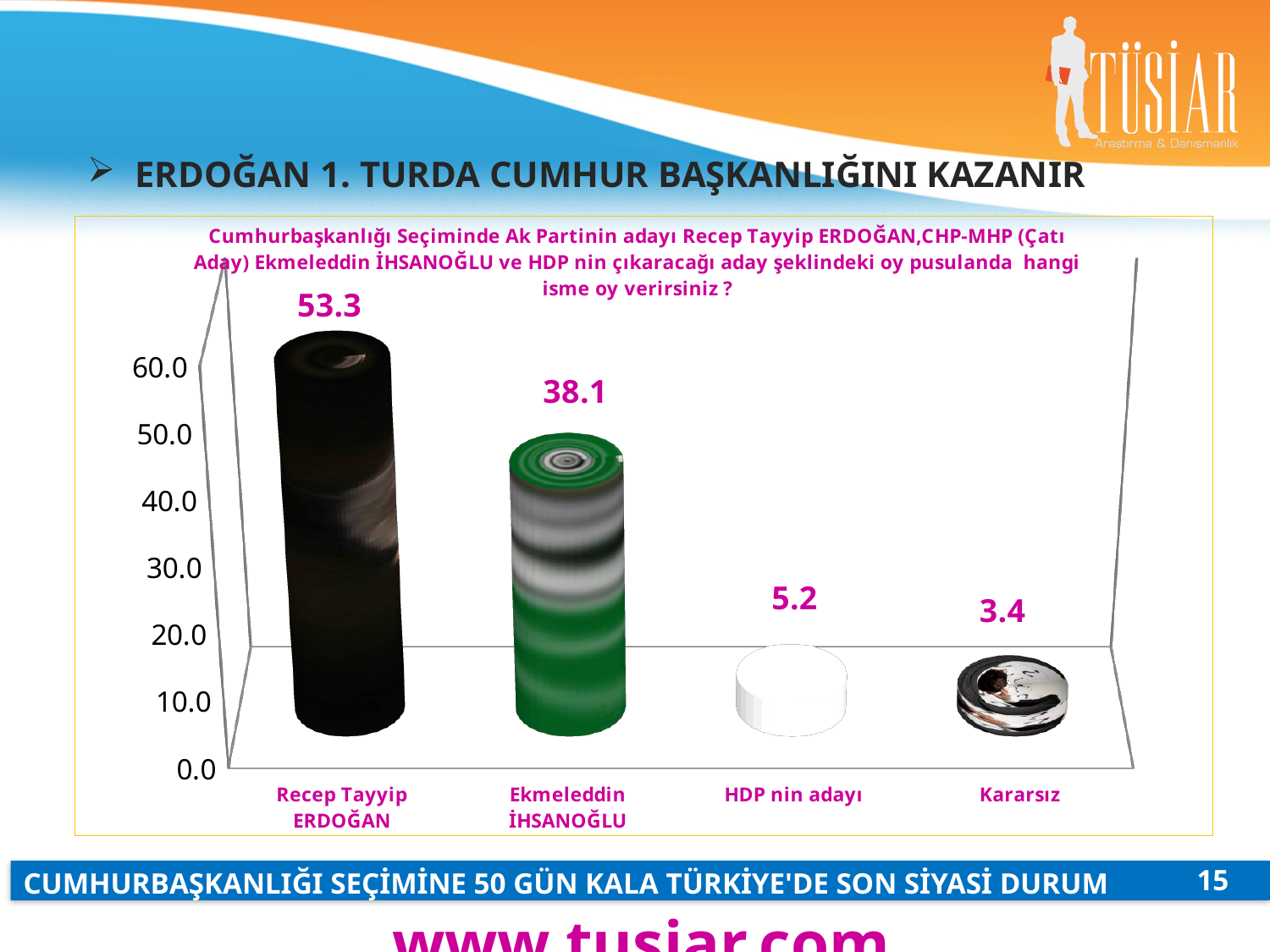
What is the value for Ekmeleddin İHSANOĞLU? 38.1 Do the values rise or fall from left to right along the x axis? fall What is the value for Kararsız? 3.4 Which category has the highest value? Recep Tayyip ERDOĞAN What kind of chart is shown on the slide? bar chart What is the value for HDP nin adayı? 5.2 Which category has the lowest value? Kararsız Which is larger, the value for HDP nin adayı or the value for Kararsız? HDP nin adayı How many categories are shown on the x axis? 4 What is the difference between the values for Recep Tayyip ERDOĞAN and Ekmeleddin İHSANOĞLU? 15.2 What is the value for Recep Tayyip ERDOĞAN? 53.3 Is the value for Ekmeleddin İHSANOĞLU greater or less than 40.0? less